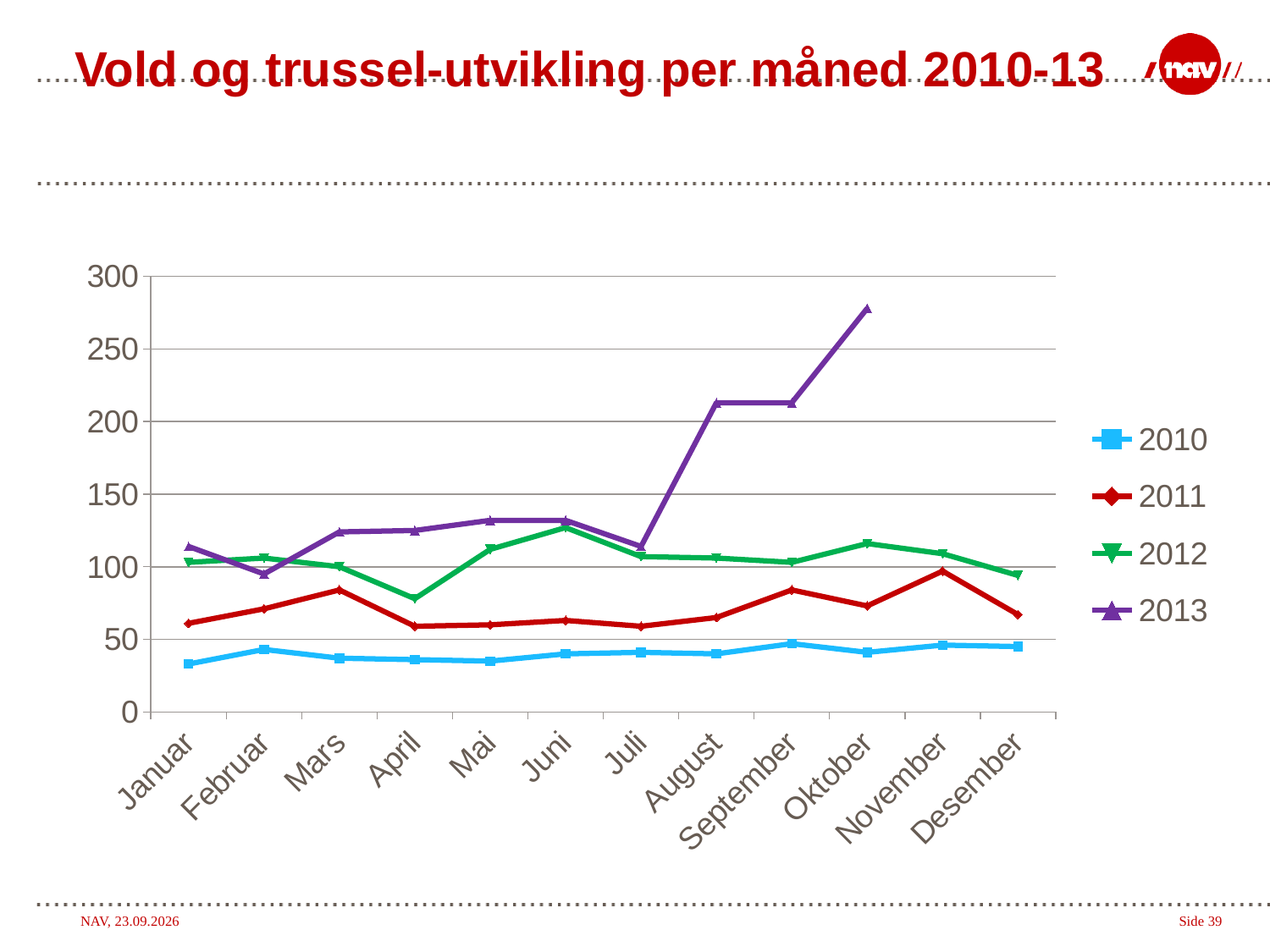
Is the value for 2013 in August greater or less than 200? greater How many months are shown along the x axis? 12 What is the title of the slide chart? Vold og trussel-utvikling per måned 2010-13 What kind of chart is shown on the slide? line chart Which series has the lowest value in Januar? 2010 In which month does the 2013 series reach its highest value? Oktober In Mai, which is larger: the value for 2012 or the value for 2011? 2012 Which series is drawn in purple? 2013 How many series does the legend list? 4 Is the value for 2013 in Oktober greater or less than 250? greater Is the value for 2012 in Juni greater or less than 100? greater